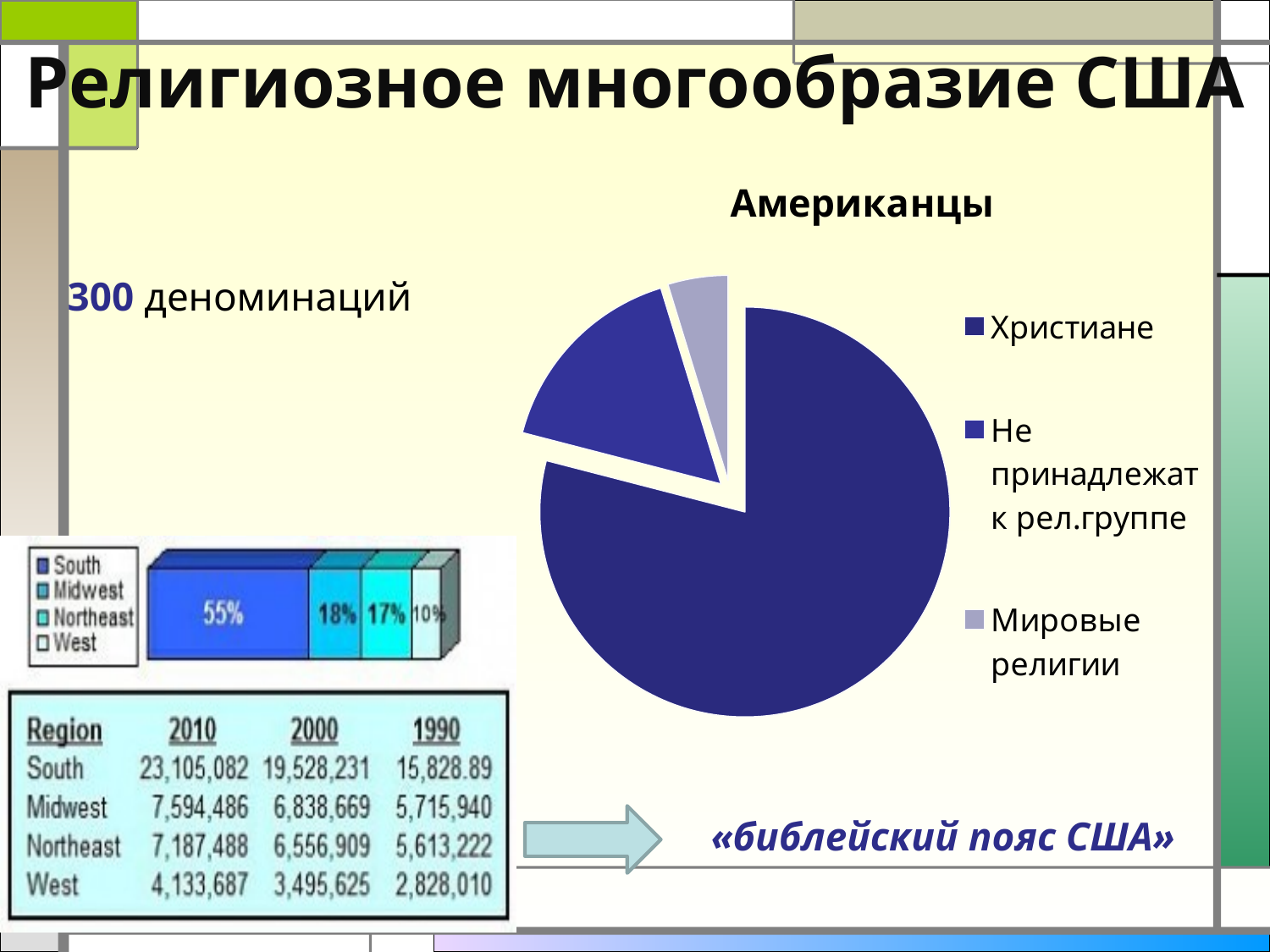
In the chart titled "Американцы", how many entries does the legend list? 3 In the bar chart in the lower left of the slide, what is the value for South? 55% What kind of chart is the chart titled "Американцы"? pie chart In the bar chart in the lower left of the slide, which region has the lowest value? West In the chart titled "Американцы", which slice is larger: "Не принадлежат к рел.группе" or "Мировые религии"? Не принадлежат к рел.группе In the bar chart in the lower left of the slide, what is the total of all segments of the stacked bar? 100% In the bar chart in the lower left of the slide, what is the difference between the values for South and Midwest? 37% In the bar chart in the lower left of the slide, what is the value for Northeast? 17% In the chart titled "Американцы", which category has the smallest slice? Мировые религии In the bar chart in the lower left of the slide, how many regions does the legend list? 4 What kind of chart is the chart in the lower left of the slide with the South/Midwest/Northeast/West legend? bar chart In the chart titled "Американцы", which category has the largest slice? Христиане